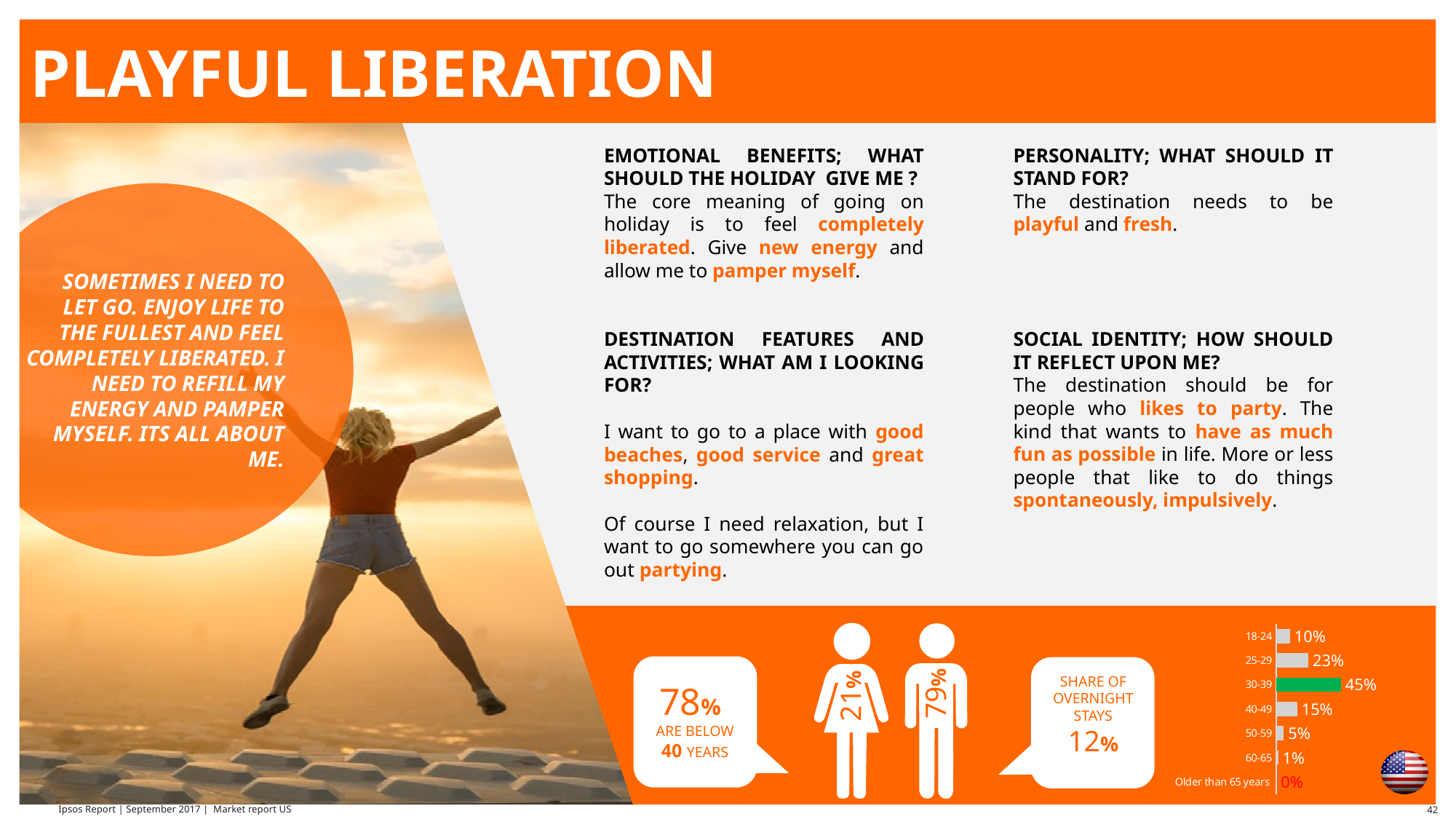
In the age-group bar chart, which age group has the highest value? 30-39 In the age-group bar chart, which age group has the lowest value? Older than 65 years What kind of chart is used to show the age-group breakdown? Bar chart In the age-group bar chart, what is the value for the 50-59 age group? 5% In the age-group bar chart, which is larger, the value for 25-29 or the value for 40-49? 25-29 In the age-group bar chart, which bar is coloured green rather than grey? 30-39 In the age-group bar chart, what is the difference between the values for the 30-39 and 25-29 age groups? 22% In the age-group bar chart, do the values rise or fall from the 30-39 group to the older age groups? Fall In the age-group bar chart, what is the value for the 18-24 age group? 10% How many age groups are shown in the age-group bar chart? 7 In the age-group bar chart, what is the value for people older than 65 years? 0% In the age-group bar chart, what is the value for the 30-39 age group? 45%